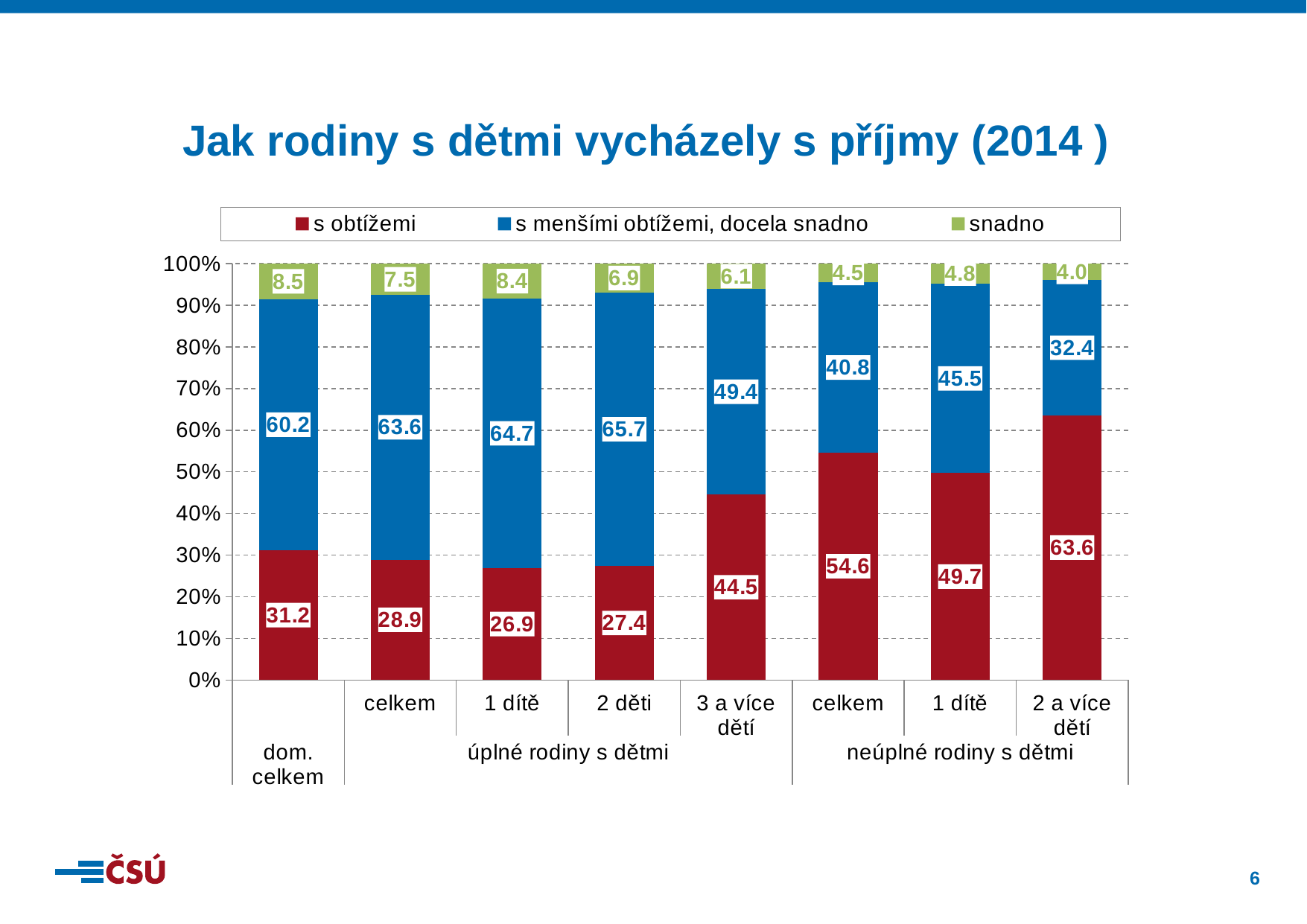
Which category has the highest value for "s menšími obtížemi, docela snadno"? 2 děti (úplné rodiny s dětmi) What is the difference between the "s obtížemi" values for "3 a více dětí" (úplné rodiny) and "1 dítě" (úplné rodiny)? 17.6 What is the value of "s menšími obtížemi, docela snadno" for "2 děti" in the "úplné rodiny s dětmi" group? 65.7 What is the value of "snadno" for "2 a více dětí" in the "neúplné rodiny s dětmi" group? 4.0 What is the value of "s obtížemi" for "celkem" in the "neúplné rodiny s dětmi" group? 54.6 What is the value of "s obtížemi" for "dom. celkem"? 31.2 How many bars (categories) are shown on the x axis? 8 Which category has the highest value for "s obtížemi"? 2 a více dětí (neúplné rodiny s dětmi) Which is larger: the "s obtížemi" value for "1 dítě" in úplné rodiny s dětmi or for "1 dítě" in neúplné rodiny s dětmi? 1 dítě in neúplné rodiny s dětmi What type of chart is shown on the slide? Stacked bar chart Which category has the lowest value for "snadno"? 2 a více dětí (neúplné rodiny s dětmi) How many series does the legend list? 3